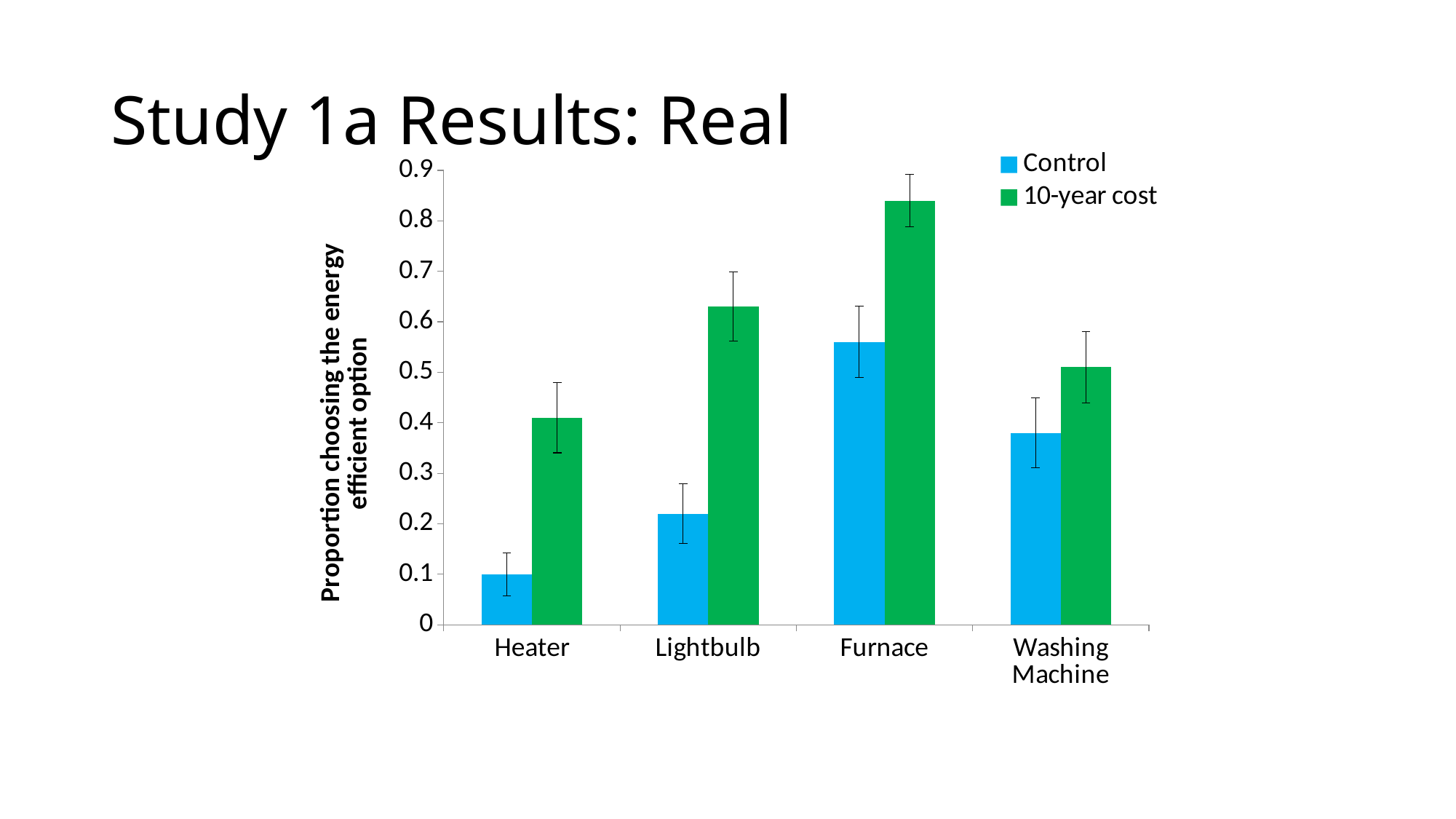
In every category, which series has the higher bar? 10-year cost What is the title of the y axis? Proportion choosing the energy efficient option Which category has the lowest Control bar? Heater Is the 10-year cost value for Heater greater or less than 0.5? less Which is larger: the Control value for Lightbulb or the Control value for Washing Machine? Washing Machine Is the 10-year cost value for Furnace greater or less than 0.8? greater What kind of chart is shown on the slide? bar chart Is the Control value for Lightbulb greater or less than 0.3? less How many product categories are shown on the x axis? 4 What colour represents the Control series? blue How many series does the legend list? 2 Which category has the highest 10-year cost bar? Furnace